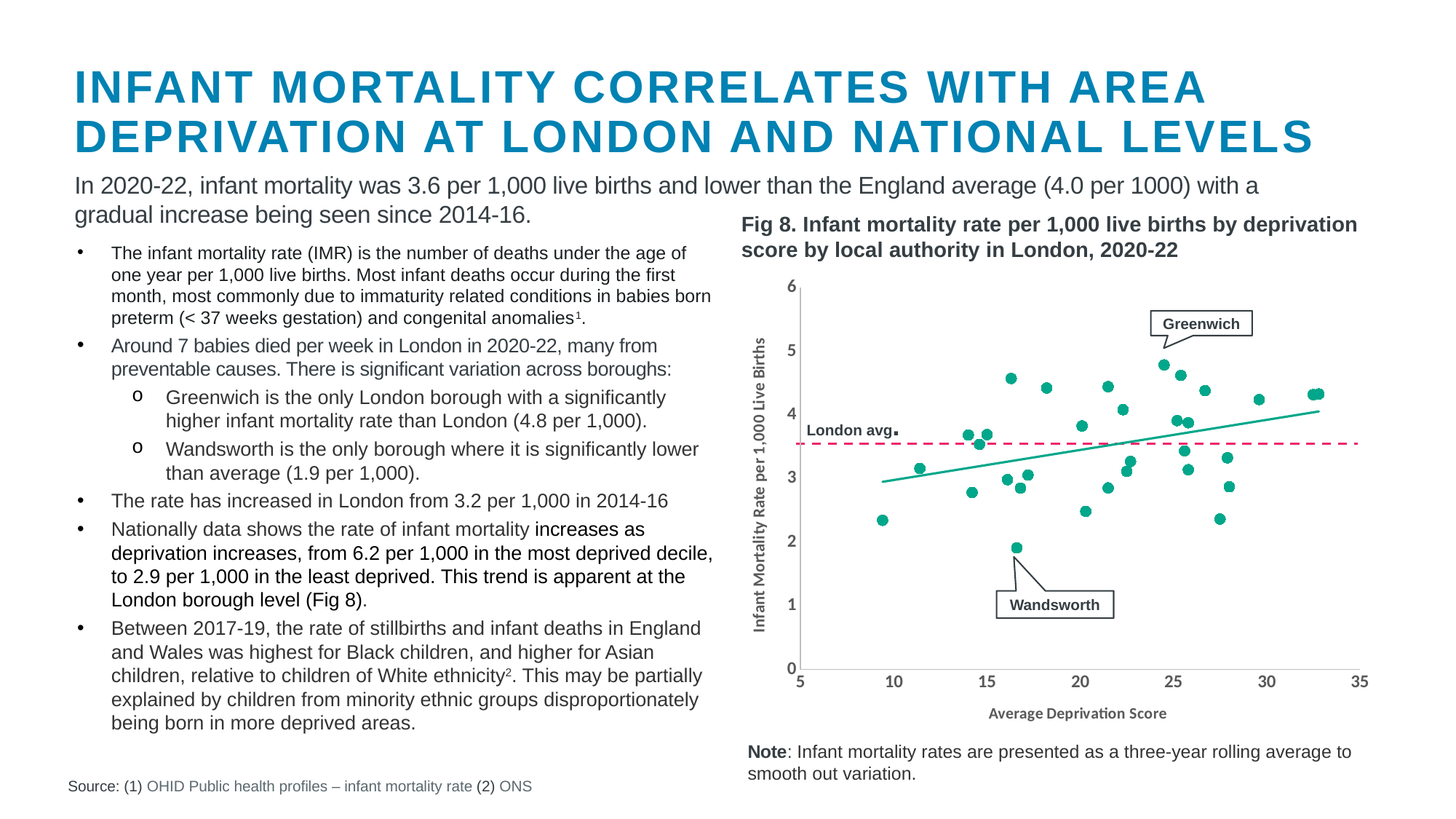
In Fig 8, is the average deprivation score for Wandsworth greater or less than 15? greater In Fig 8, is the London average infant mortality rate (dashed line) greater or less than 4? less In Fig 8, is the London average infant mortality rate (dashed line) greater or less than 3? greater What is the label on the x axis of Fig 8? Average Deprivation Score In Fig 8, which labelled borough has the highest infant mortality rate? Greenwich In Fig 8, does the trend line show infant mortality rising or falling as average deprivation score increases? Rising What does the dashed horizontal line in Fig 8 represent? London avg. In Fig 8, which labelled borough has the lowest infant mortality rate? Wandsworth In Fig 8, which has the higher infant mortality rate, Greenwich or Wandsworth? Greenwich What kind of chart is Fig 8? Scatter chart